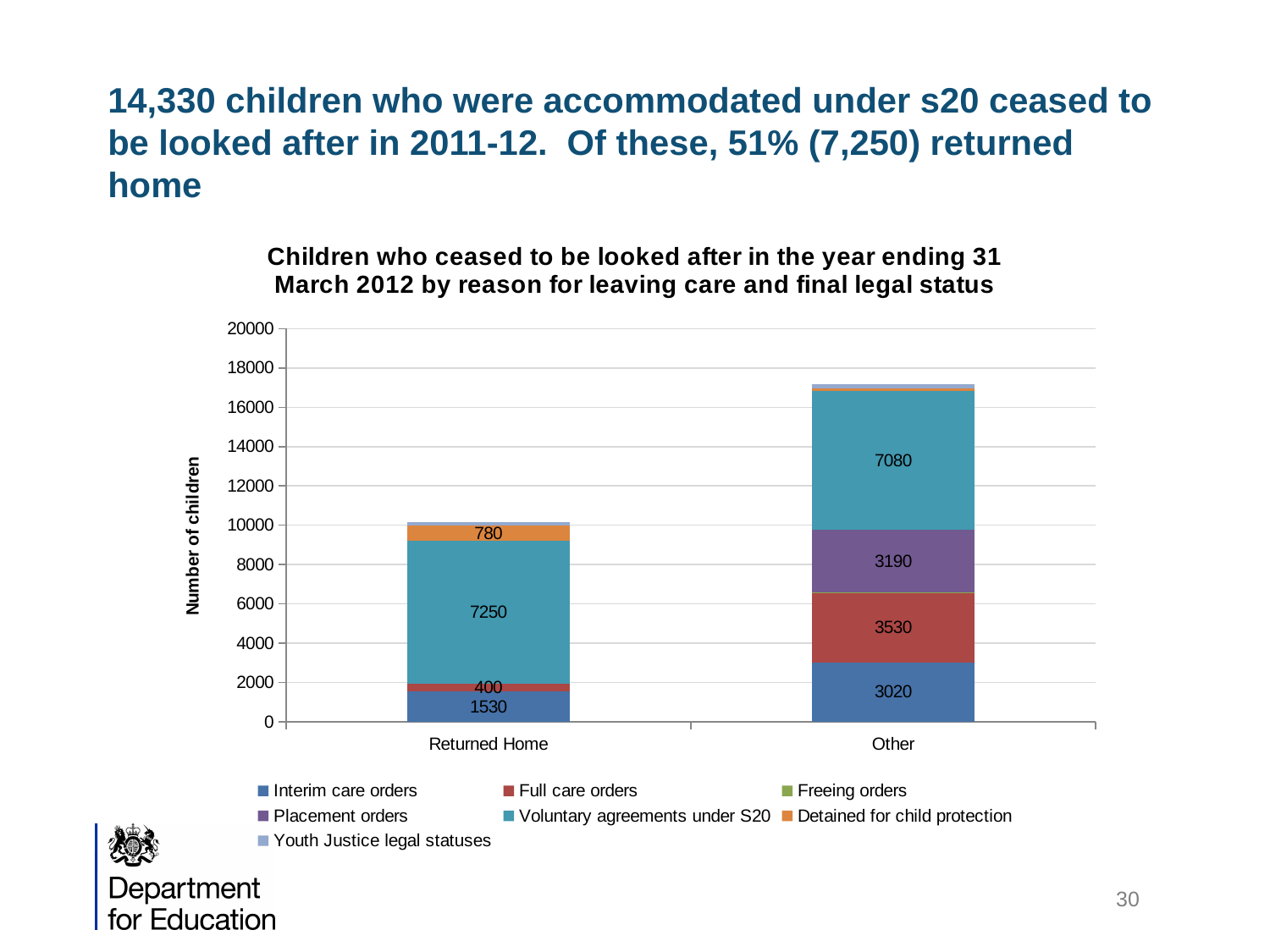
How many series does the legend list? 7 How many categories are shown on the x axis? 2 Which is larger: Interim care orders for Returned Home or Interim care orders for Other? Other What type of chart is shown on the slide? Stacked bar chart Which series has the largest segment in the Other bar? Voluntary agreements under S20 What is the difference between Full care orders in the Other bar and Full care orders in the Returned Home bar? 3130 Is the total height of the Other bar greater or less than 16000? greater What is the label of the y axis? Number of children What is the value for Detained for child protection in the Returned Home bar? 780 What is the value for Placement orders in the Other bar? 3190 What is the value for Interim care orders in the Other bar? 3020 What is the value for Voluntary agreements under S20 in the Returned Home bar? 7250